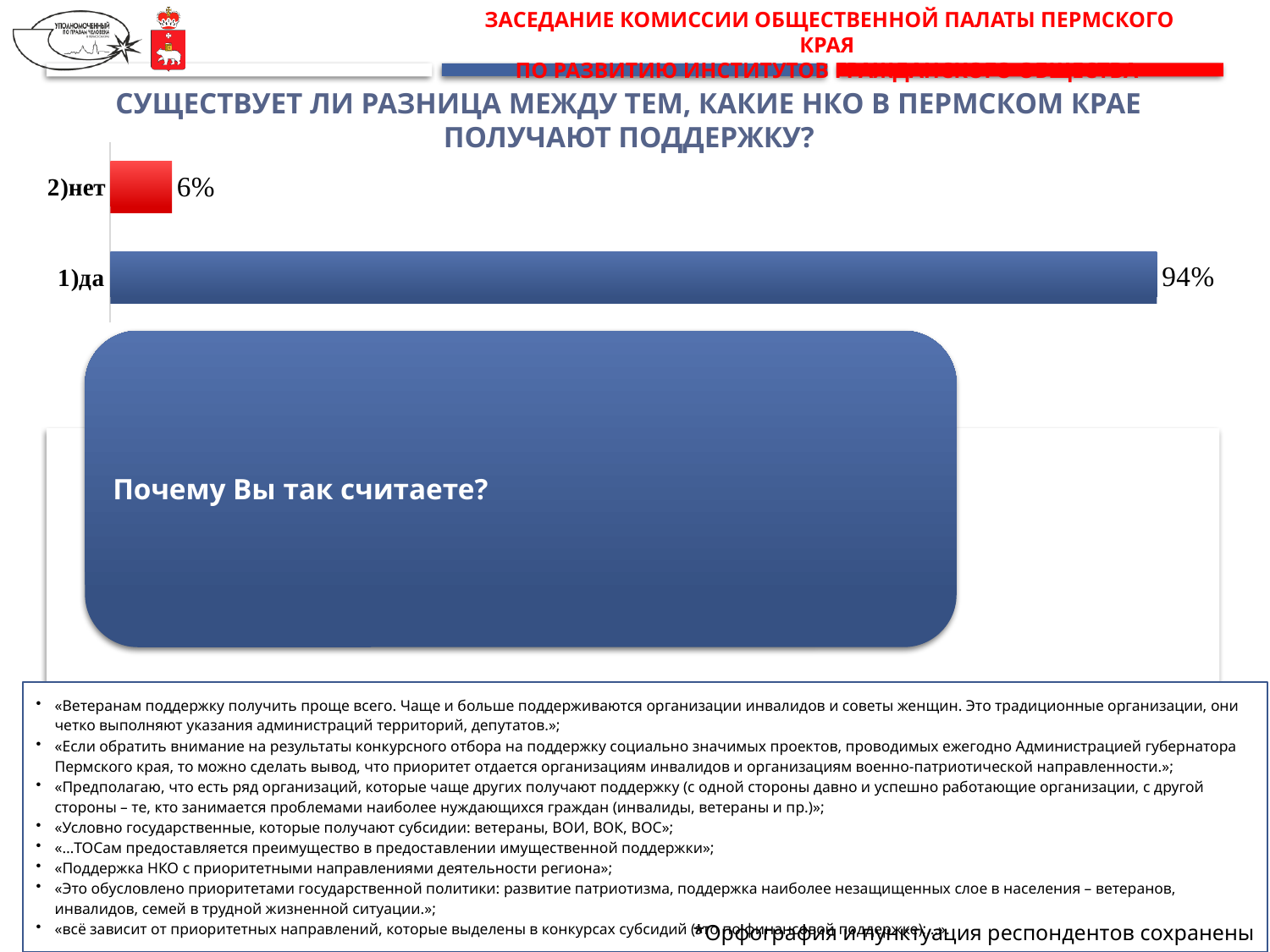
Which answer option has the highest value in the chart? 1)да What is the total of the two values shown in the chart? 100% What is the difference between the values for "1)да" and "2)нет"? 88% What type of chart is shown on the slide? Bar chart What percentage of respondents answered "1)да"? 94% What colour is the bar for "1)да"? Blue Which is larger, the value for "1)да" or the value for "2)нет"? 1)да What colour is the bar for "2)нет"? Red How many answer categories are shown in the chart? 2 Which answer option has the lowest value in the chart? 2)нет What percentage of respondents answered "2)нет"? 6%